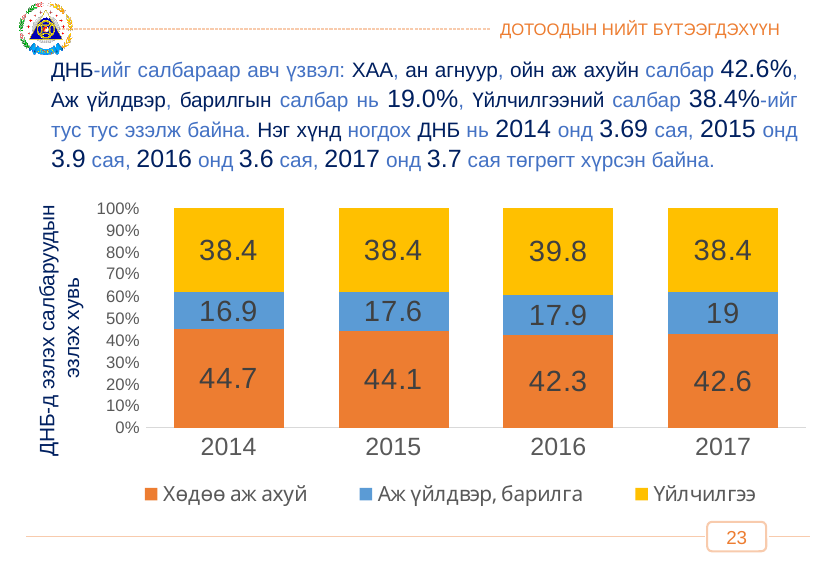
Does the Аж үйлдвэр, барилга value rise or fall from 2014 to 2017? Rise How many series does the legend list? 3 What is the value for Аж үйлдвэр, барилга in 2017? 19 What kind of chart is shown on the slide? Stacked bar chart In which year is the Хөдөө аж ахуй value the highest? 2014 How many years are shown on the x axis of the chart? 4 In which year is the Аж үйлдвэр, барилга value the lowest? 2014 What is the value for Хөдөө аж ахуй in 2014? 44.7 What is the value for Үйлчилгээ in 2016? 39.8 Which colour represents Үйлчилгээ in the chart? Yellow What is the difference between the Хөдөө аж ахуй values in 2014 and 2017? 2.1 Which is larger: the Үйлчилгээ value in 2016 or in 2017? 2016